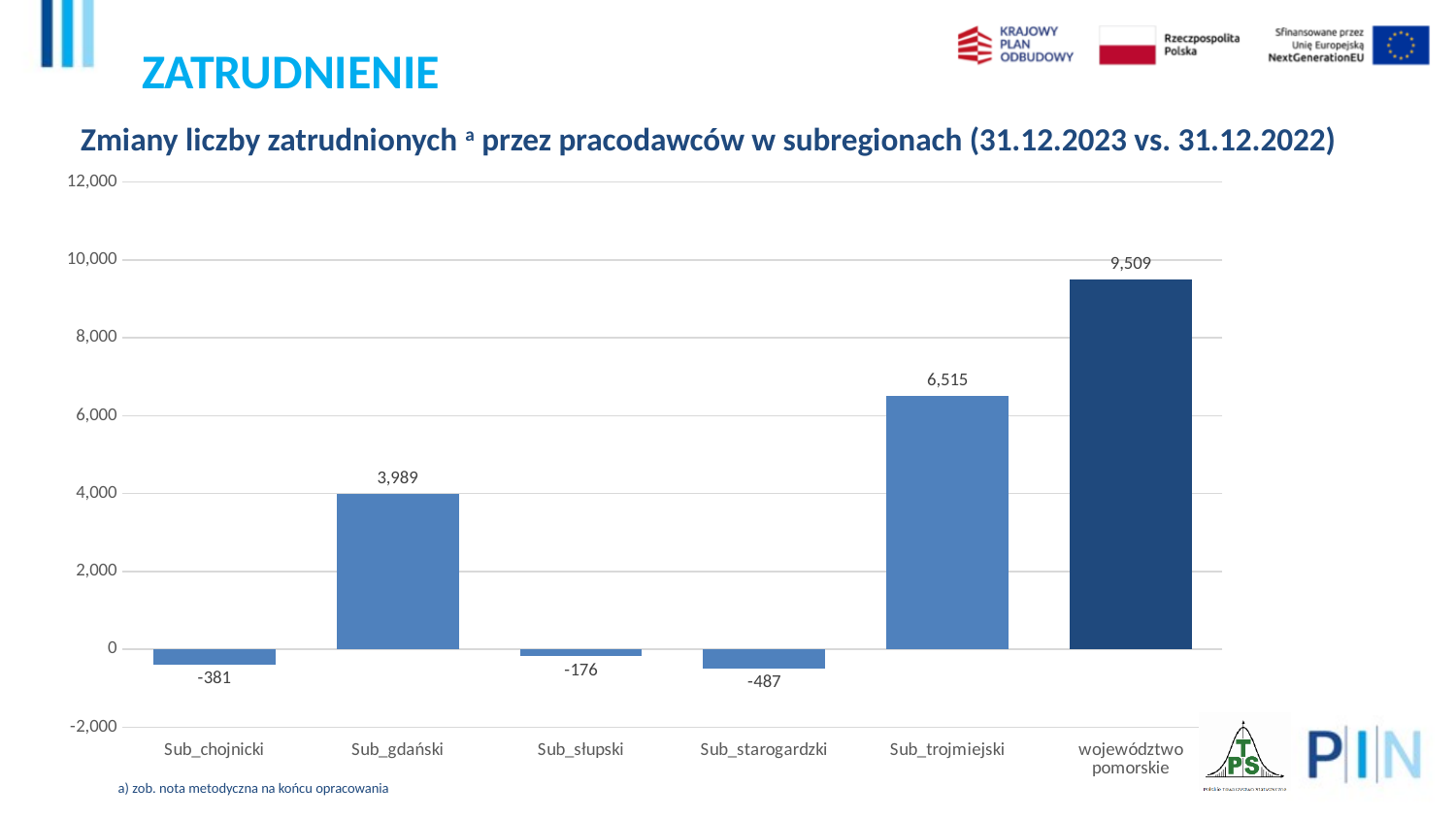
What is the title of the chart? Zmiany liczby zatrudnionych przez pracodawców w subregionach (31.12.2023 vs. 31.12.2022) What is the difference between the values for województwo pomorskie and Sub_trojmiejski? 2,994 What is the value for Sub_gdański? 3,989 What is the value for Sub_trojmiejski? 6,515 What kind of chart is shown on the slide? bar chart What is the value for Sub_starogardzki? -487 What is the value for Sub_słupski? -176 Which category has the lowest value? Sub_starogardzki How many categories are shown on the x axis? 6 Which category has the highest value? województwo pomorskie Which is larger, the value for Sub_gdański or the value for Sub_trojmiejski? Sub_trojmiejski Is the value for województwo pomorskie greater or less than 8,000? greater